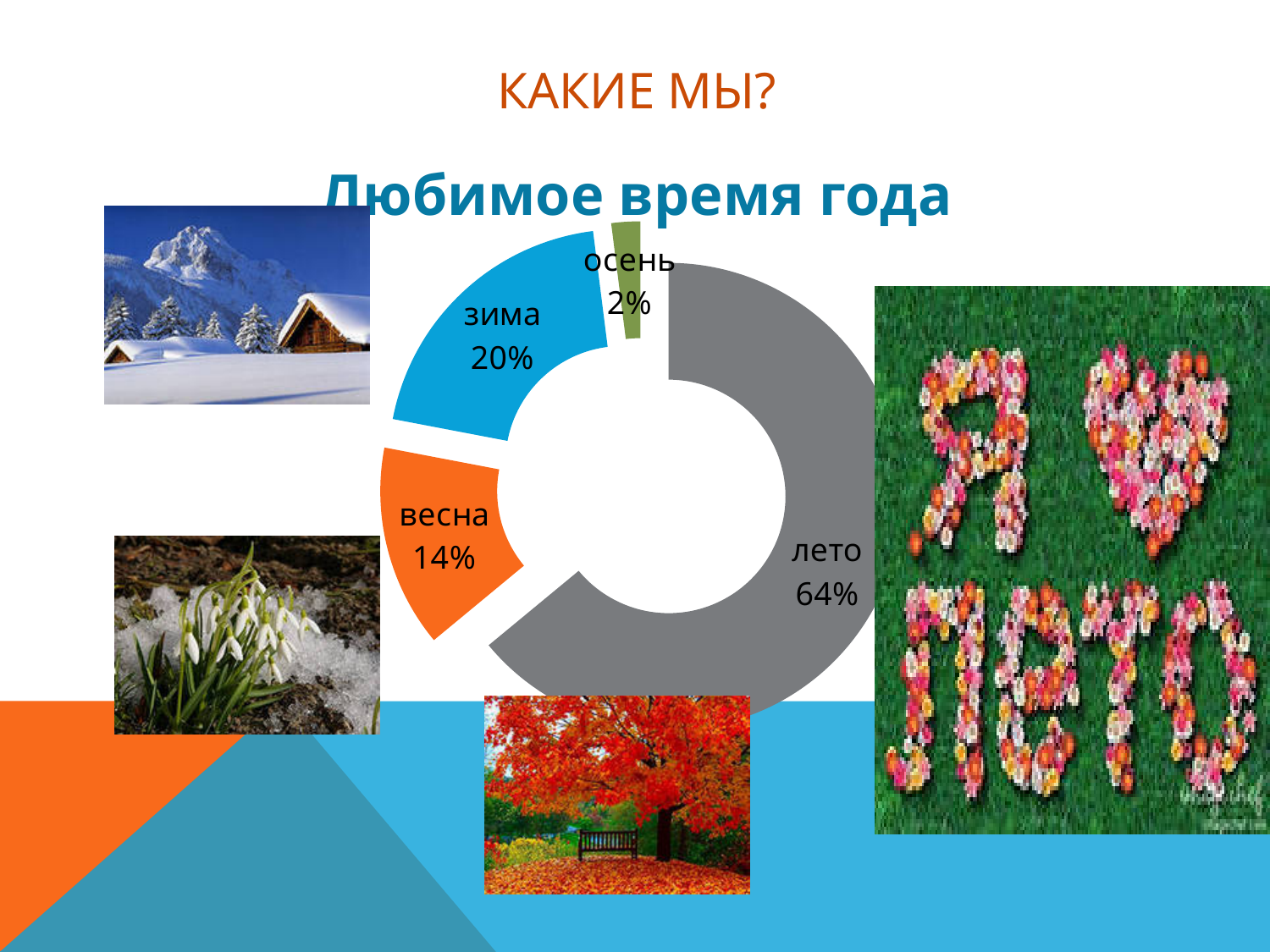
Which season has the largest share in the chart? лето What colour is the segment for весна? orange What percentage is shown for лето? 64% What is the difference in percentage points between лето and зима? 44 What kind of chart is shown on the slide? doughnut chart What percentage is shown for зима? 20% What percentage is shown for осень? 2% Which season has the smallest share in the chart? осень Which has a larger share, зима or весна? зима What percentage is shown for весна? 14% What is the title of the chart? Любимое время года How many categories does the chart show? 4